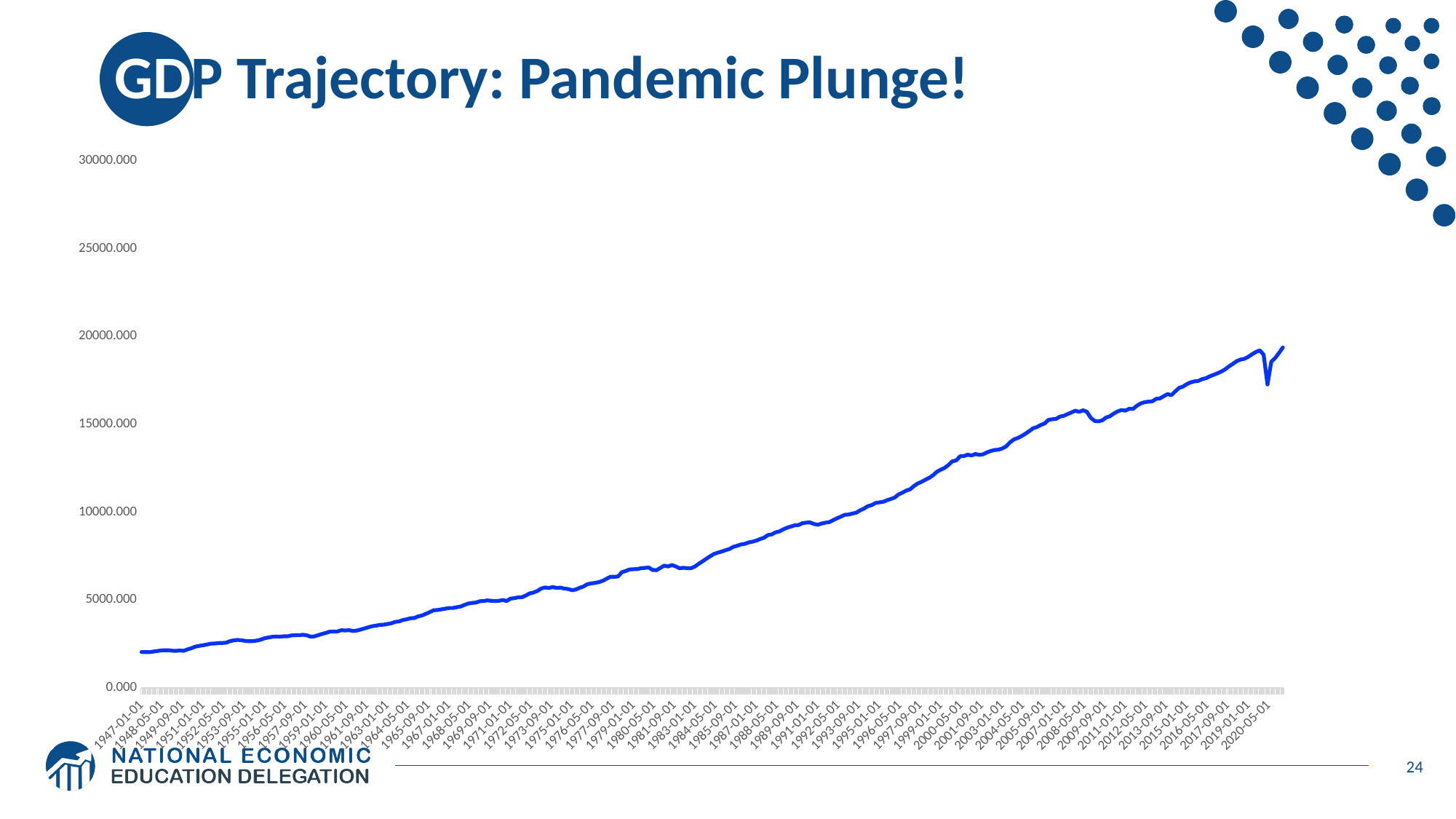
Overall, do the values rise or fall along the x axis from 1947 to 2020? rise Is the value at 1947-01-01 greater or less than 5000? less Is the value at 1999-01-01 greater or less than 10000? greater Is the value at 2020-05-01 greater or less than 15000? greater What is the highest tick value shown on the y axis? 30000.000 Is the value at 1984-05-01 larger or smaller than the value at 1999-01-01? smaller What is the title of the slide's chart? GDP Trajectory: Pandemic Plunge! What kind of chart is shown on the slide? line chart